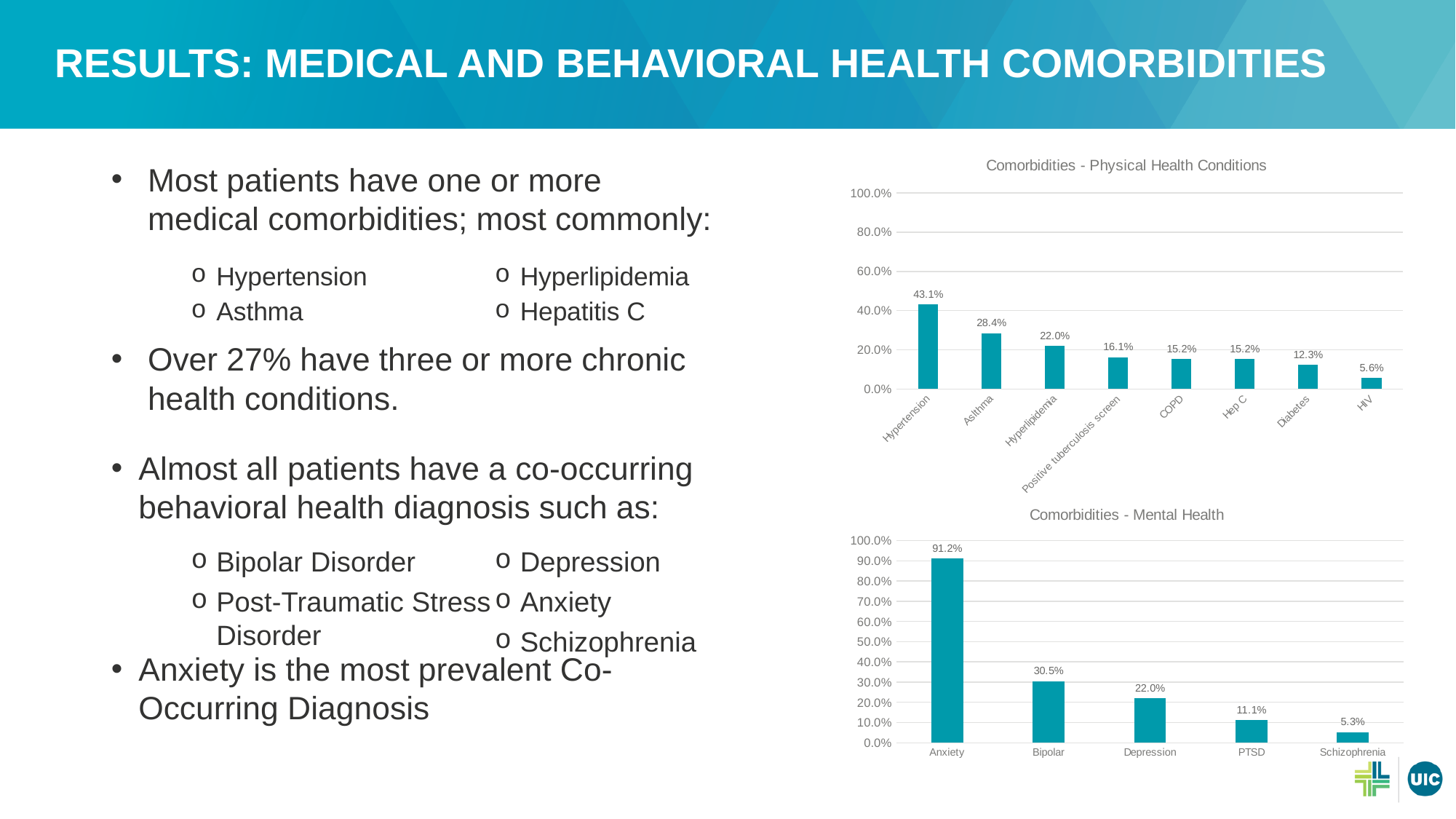
In the 'Comorbidities - Physical Health Conditions' chart, which category has the lowest value? HIV In the 'Comorbidities - Physical Health Conditions' chart, is the value for Diabetes greater or less than 20.0%? less In the 'Comorbidities - Physical Health Conditions' chart, how many categories are plotted? 8 In the 'Comorbidities - Physical Health Conditions' chart, what is the value for Hypertension? 43.1% In the 'Comorbidities - Mental Health' chart, what is the value for Anxiety? 91.2% What type of chart is the 'Comorbidities - Mental Health' chart? Bar chart In the 'Comorbidities - Physical Health Conditions' chart, what is the difference between Hypertension and Asthma? 14.7% In the 'Comorbidities - Mental Health' chart, what is the difference between Anxiety and Bipolar? 60.7% In the 'Comorbidities - Mental Health' chart, which category has the highest value? Anxiety In the 'Comorbidities - Physical Health Conditions' chart, what is the value for Positive tuberculosis screen? 16.1% In the 'Comorbidities - Mental Health' chart, which is larger, Bipolar or Depression? Bipolar In the 'Comorbidities - Mental Health' chart, how many categories are plotted? 5